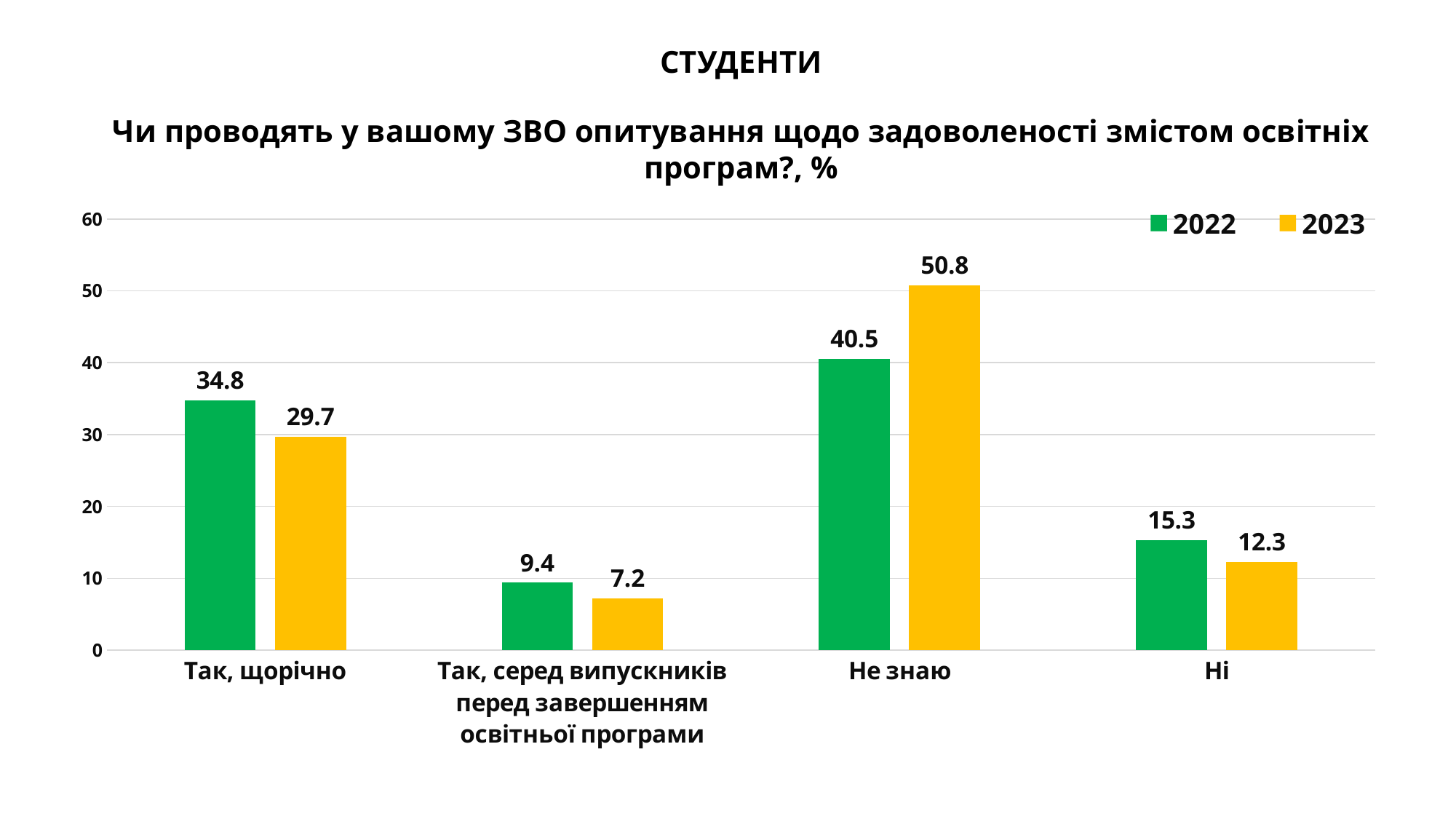
What is the 2022 value for "Так, щорічно"? 34.8 What kind of chart is shown on the slide? bar chart Which category has the lowest 2022 value? Так, серед випускників перед завершенням освітньої програми Which is larger for "Так, щорічно": the 2022 value or the 2023 value? 2022 Which colour represents the 2023 series? yellow Which category has the highest 2023 value? Не знаю How many series does the legend list? 2 What is the 2023 value for "Так, серед випускників перед завершенням освітньої програми"? 7.2 What is the 2023 value for "Не знаю"? 50.8 What is the difference between the 2023 and 2022 values for "Не знаю"? 10.3 What is the 2022 value for "Ні"? 15.3 How many categories are shown on the x axis? 4